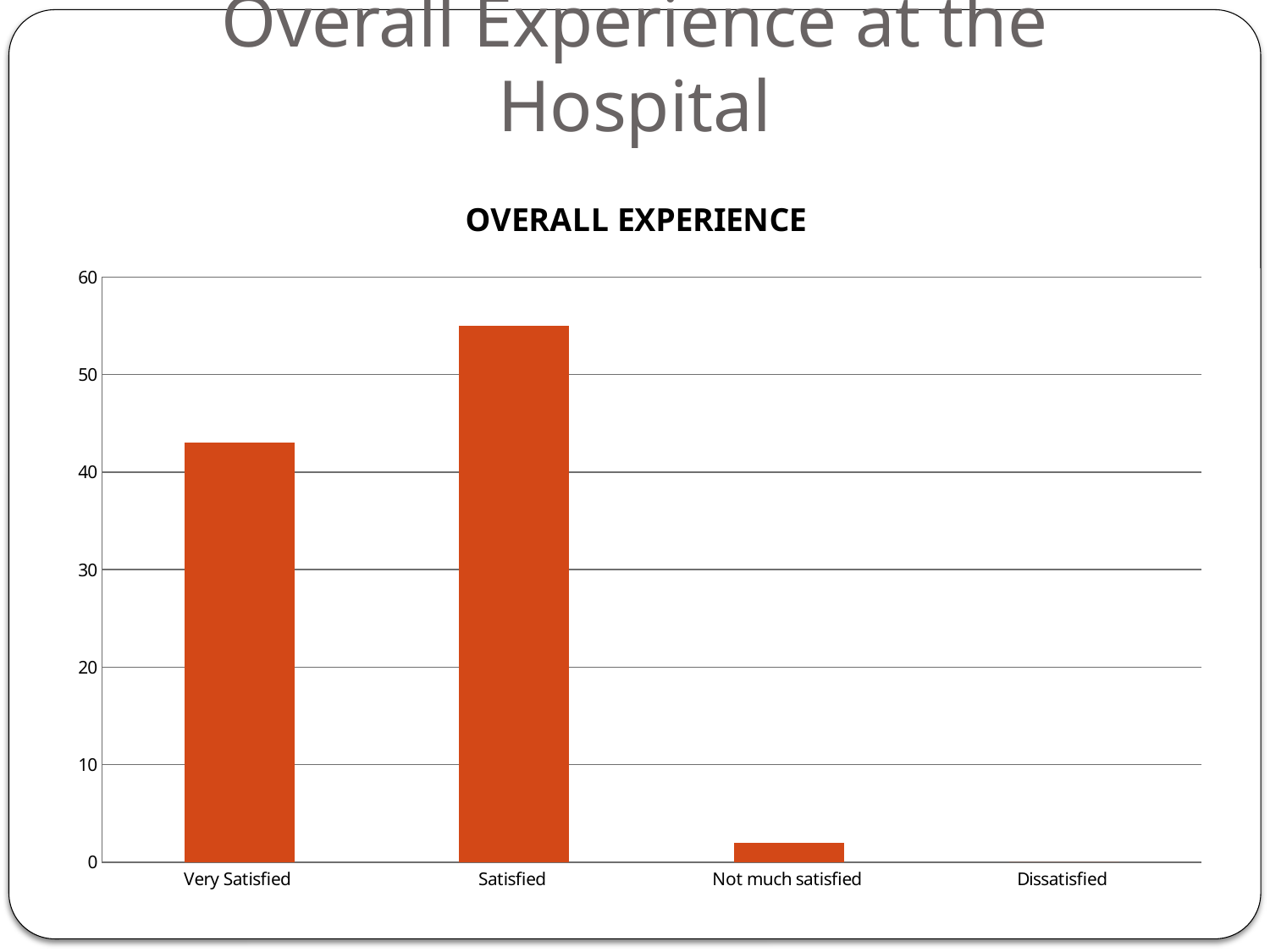
Is the value for Satisfied greater or less than 50? greater Which is larger, the value for Very Satisfied or the value for Satisfied? Satisfied How many categories are shown on the x axis of the chart? 4 Which category has the lowest value? Dissatisfied What is the title of the chart? OVERALL EXPERIENCE What kind of chart is shown on the slide? bar chart Do the values rise or fall along the x axis from Satisfied to Dissatisfied? fall Which category has the highest value? Satisfied Which is larger, the value for Not much satisfied or the value for Very Satisfied? Very Satisfied Is the value for Very Satisfied greater or less than 40? greater Is the value for Very Satisfied greater or less than 50? less